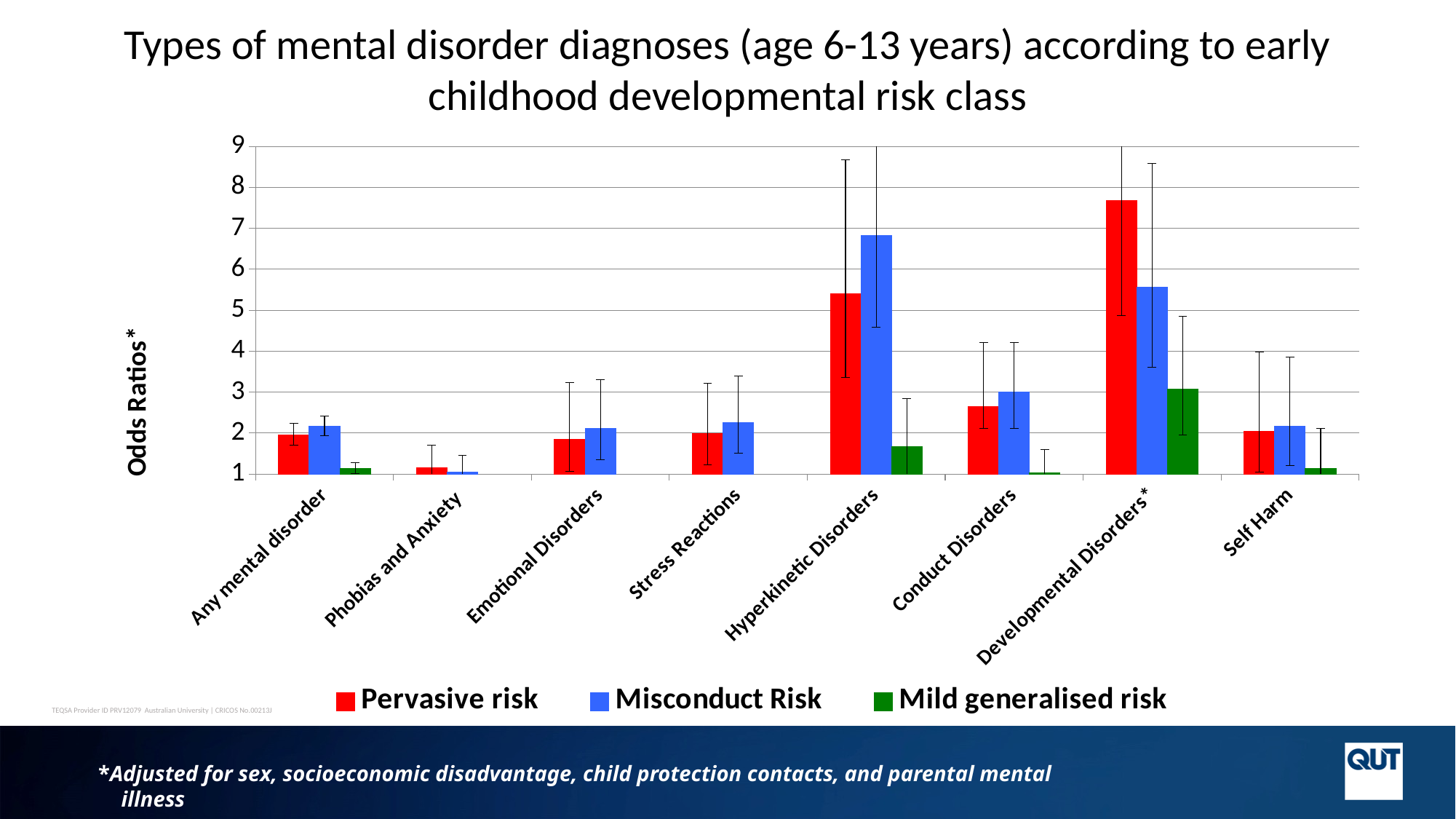
For Hyperkinetic Disorders, which is larger: the Pervasive risk value or the Misconduct Risk value? Misconduct Risk Is the Misconduct Risk value for Hyperkinetic Disorders greater or less than 6? greater For which category is the Pervasive risk odds ratio lowest? Phobias and Anxiety Is the Pervasive risk value for Developmental Disorders* greater or less than 7? greater What is the label on the vertical axis? Odds Ratios* Is the Mild generalised risk value for Hyperkinetic Disorders greater or less than 2? less What kind of chart is shown on the slide? bar chart How many series does the legend list? 3 For which category is the Pervasive risk odds ratio highest? Developmental Disorders* For Developmental Disorders*, which is larger: the Pervasive risk value or the Misconduct Risk value? Pervasive risk How many diagnosis categories are shown on the x axis? 8 For which category is the Misconduct Risk odds ratio highest? Hyperkinetic Disorders